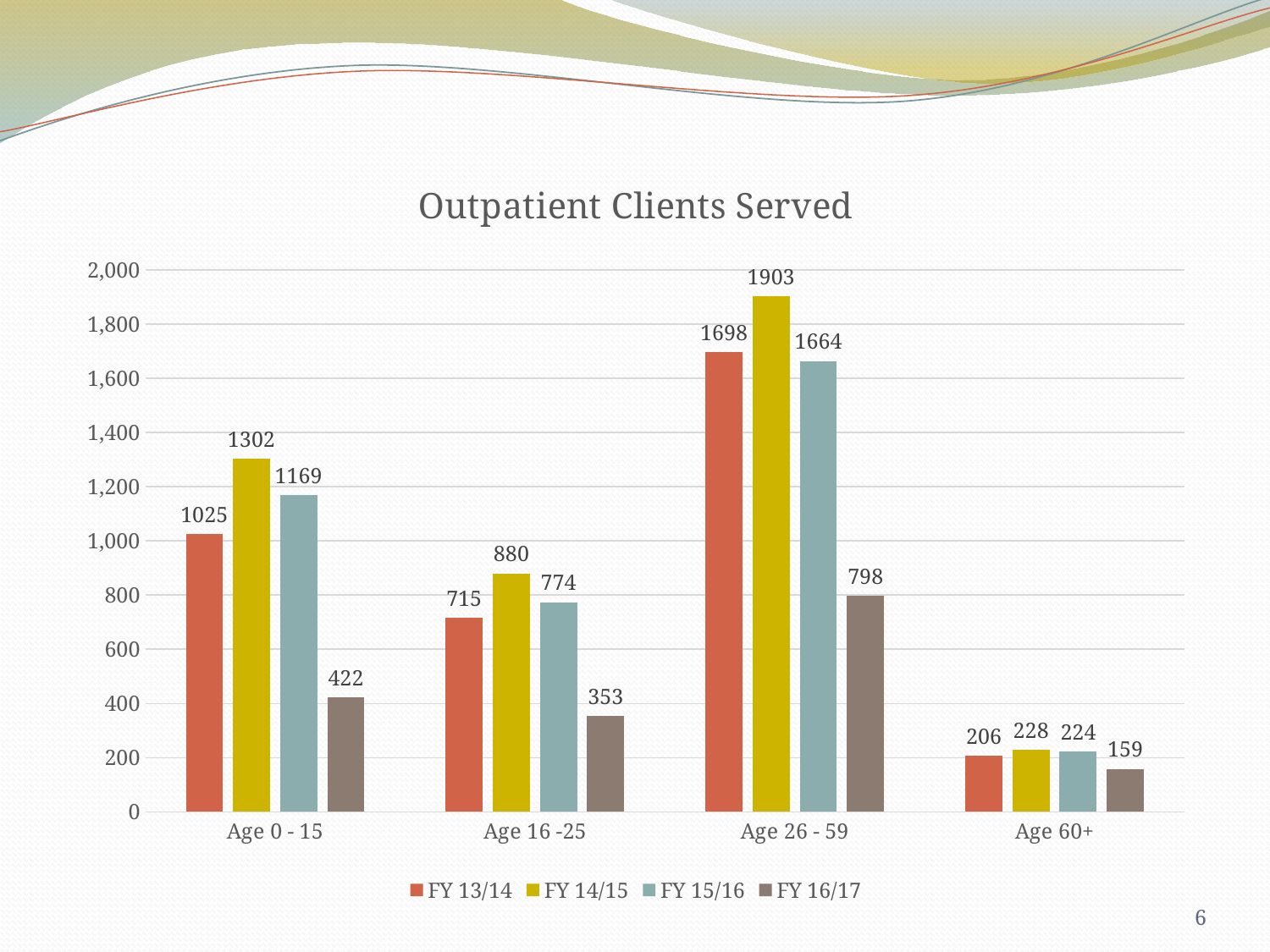
What kind of chart is shown on the slide? bar chart Which is larger in the Age 0 - 15 category: FY 13/14 or FY 15/16? FY 15/16 What is the value for FY 16/17 in the Age 0 - 15 category? 422 What is the value for FY 14/15 in the Age 26 - 59 category? 1903 What is the difference between the FY 14/15 and FY 16/17 values in the Age 26 - 59 category? 1105 How many age categories are shown on the x axis? 4 Is the FY 14/15 value for Age 16 -25 greater or less than 800? greater What is the value for FY 13/14 in the Age 16 -25 category? 715 Which age category has the highest FY 15/16 value? Age 26 - 59 Which age category has the lowest FY 13/14 value? Age 60+ How many series does the legend list? 4 What is the title of the chart? Outpatient Clients Served